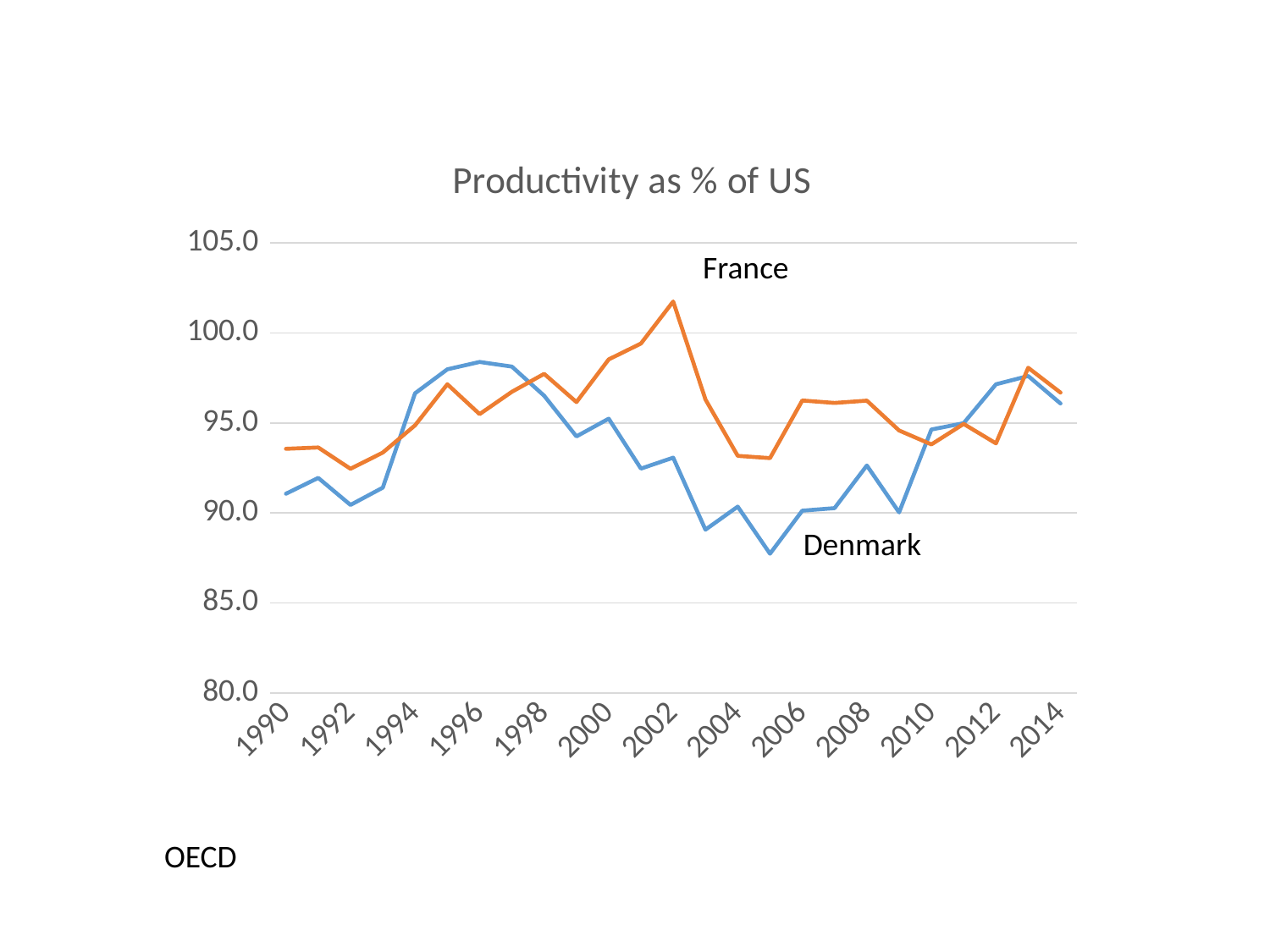
What kind of chart is shown on the slide? line chart Does the Denmark line rise or fall between 1996 and 2005? fall How many lines (series) are plotted on the chart? 2 In 1996, which series has the higher value, France or Denmark? Denmark Is the value for Denmark in 2005 greater or less than 90.0? less In 2005, which series has the higher value, France or Denmark? France Is the value for Denmark in 1996 greater or less than 95.0? greater In which year does the Denmark line reach its lowest value? 2005 Is the value for France in 1990 greater or less than 95.0? less What is the title of the chart? Productivity as % of US In which year does the France line reach its highest value? 2002